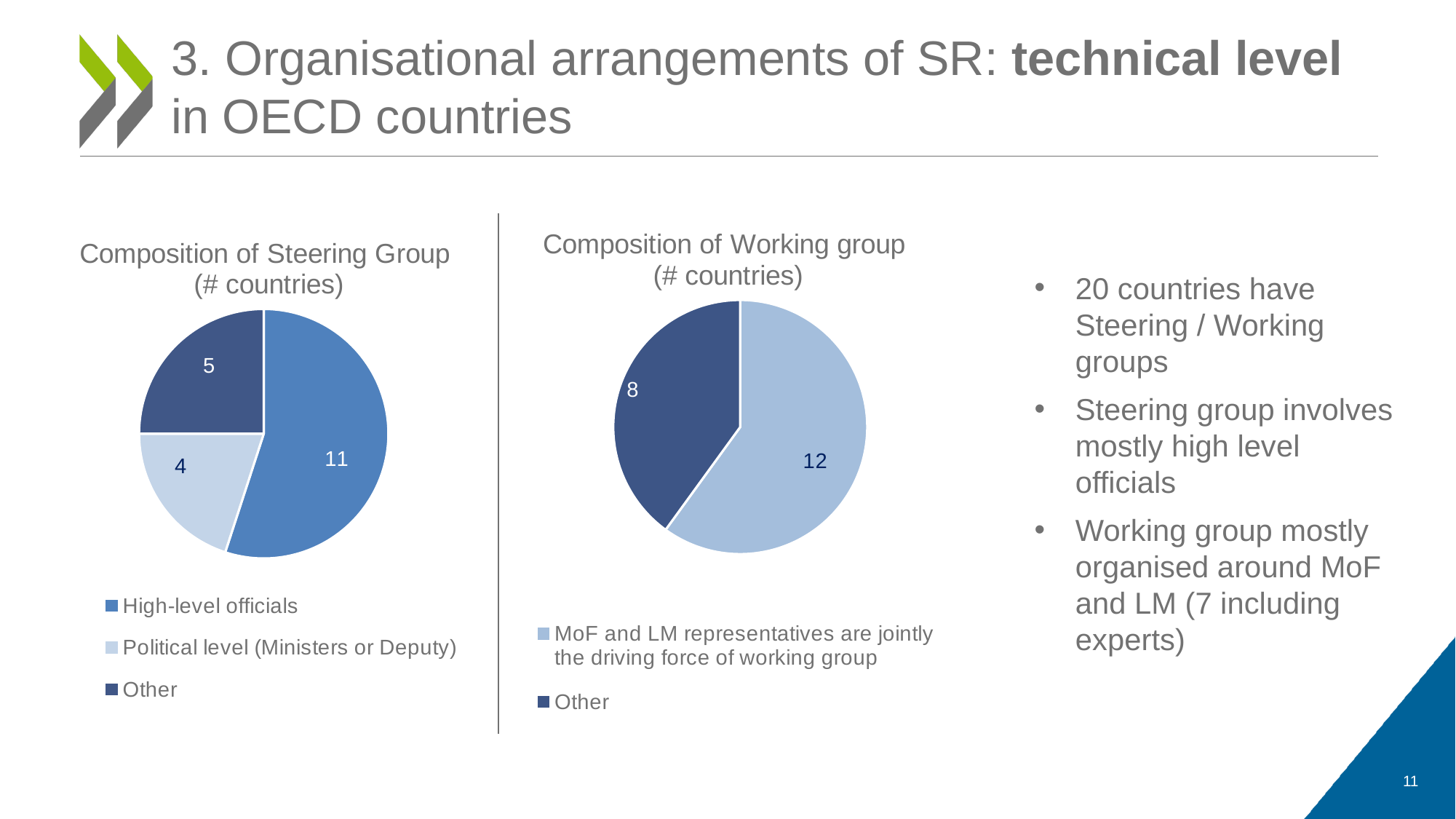
In the 'Composition of Steering Group' chart, what is the difference between the 'High-level officials' value and the 'Other' value? 6 In the 'Composition of Working group' chart, what is the value for 'Other'? 8 In the 'Composition of Steering Group' chart, what share of the pie does 'High-level officials' represent? 55% In the 'Composition of Working group' chart, which is larger: 'MoF and LM representatives are jointly the driving force of working group' or 'Other'? MoF and LM representatives are jointly the driving force of working group In the 'Composition of Steering Group' chart, how many countries have high-level officials in the steering group? 11 In the 'Composition of Steering Group' chart, which category has the largest slice? High-level officials In the 'Composition of Steering Group' chart, which category has the smallest slice? Political level (Ministers or Deputy) In the 'Composition of Working group' chart, what is the difference between the two slices? 4 How many slices does the 'Composition of Steering Group' pie chart have? 3 What type of chart is used for 'Composition of Working group'? Pie chart In the 'Composition of Working group' chart, what share of the pie does 'Other' represent? 40% In the 'Composition of Steering Group' chart, what is the value for 'Political level (Ministers or Deputy)'? 4